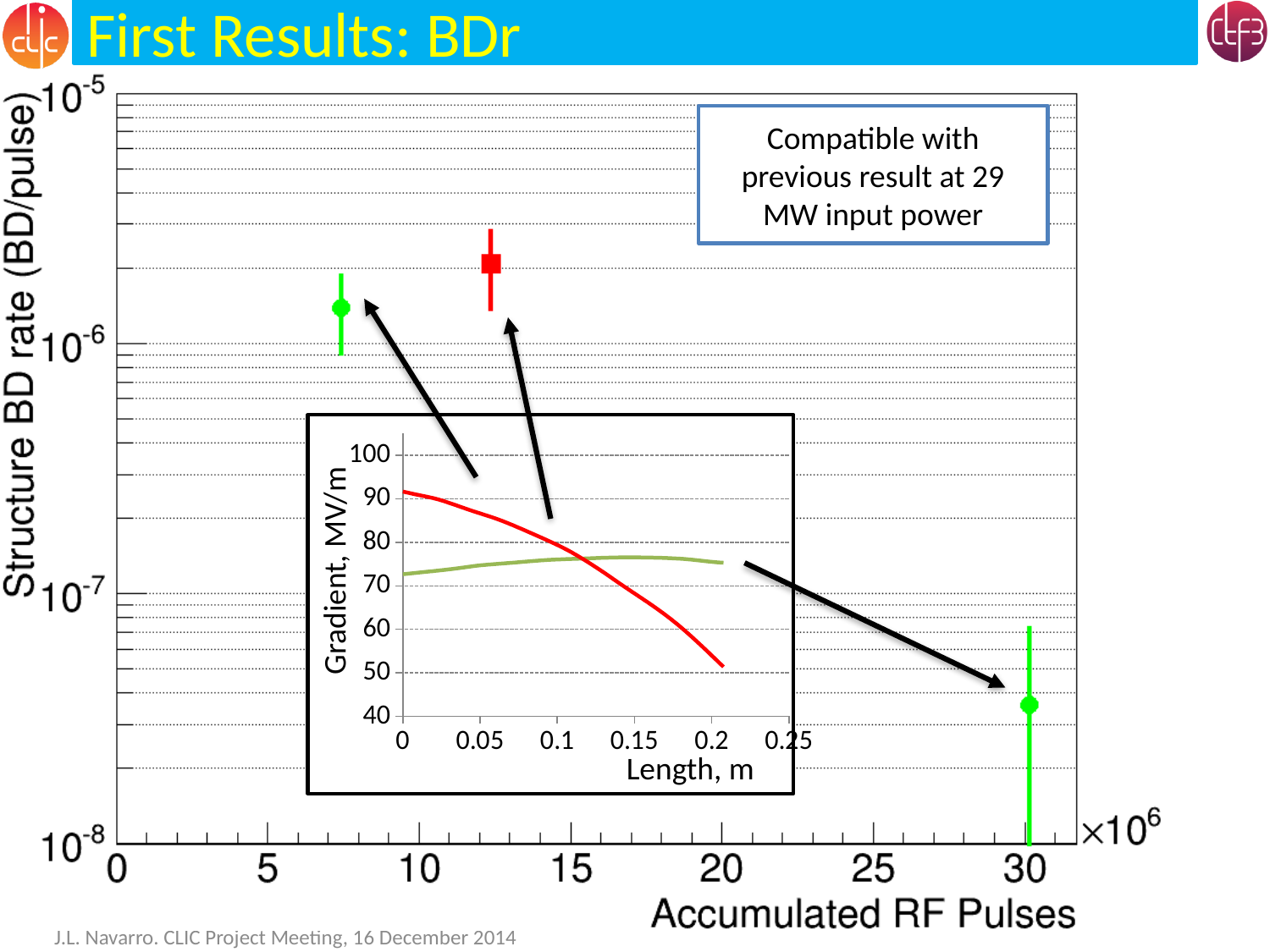
In the inset chart, does the red line rise or fall as Length increases? falls What kind of chart is the main chart on the slide? scatter plot In the main chart, is the BD rate of the red square point greater or less than 10^-6? greater What kind of chart is the inset chart of Gradient versus Length? line chart In the main chart, which point has the highest Structure BD rate? the red square How many data points are plotted in the main chart of Structure BD rate versus Accumulated RF Pulses? 3 How many lines are plotted in the inset Gradient versus Length chart? 2 In the main chart, which point has the lowest Structure BD rate? the green point near 30×10^6 pulses What is the x-axis label of the main chart? Accumulated RF Pulses In the main chart, is the BD rate of the green point near 30×10^6 accumulated RF pulses greater or less than 10^-7? less In the inset chart, at Length 0.05 m, which line has the higher gradient, the red or the green? red